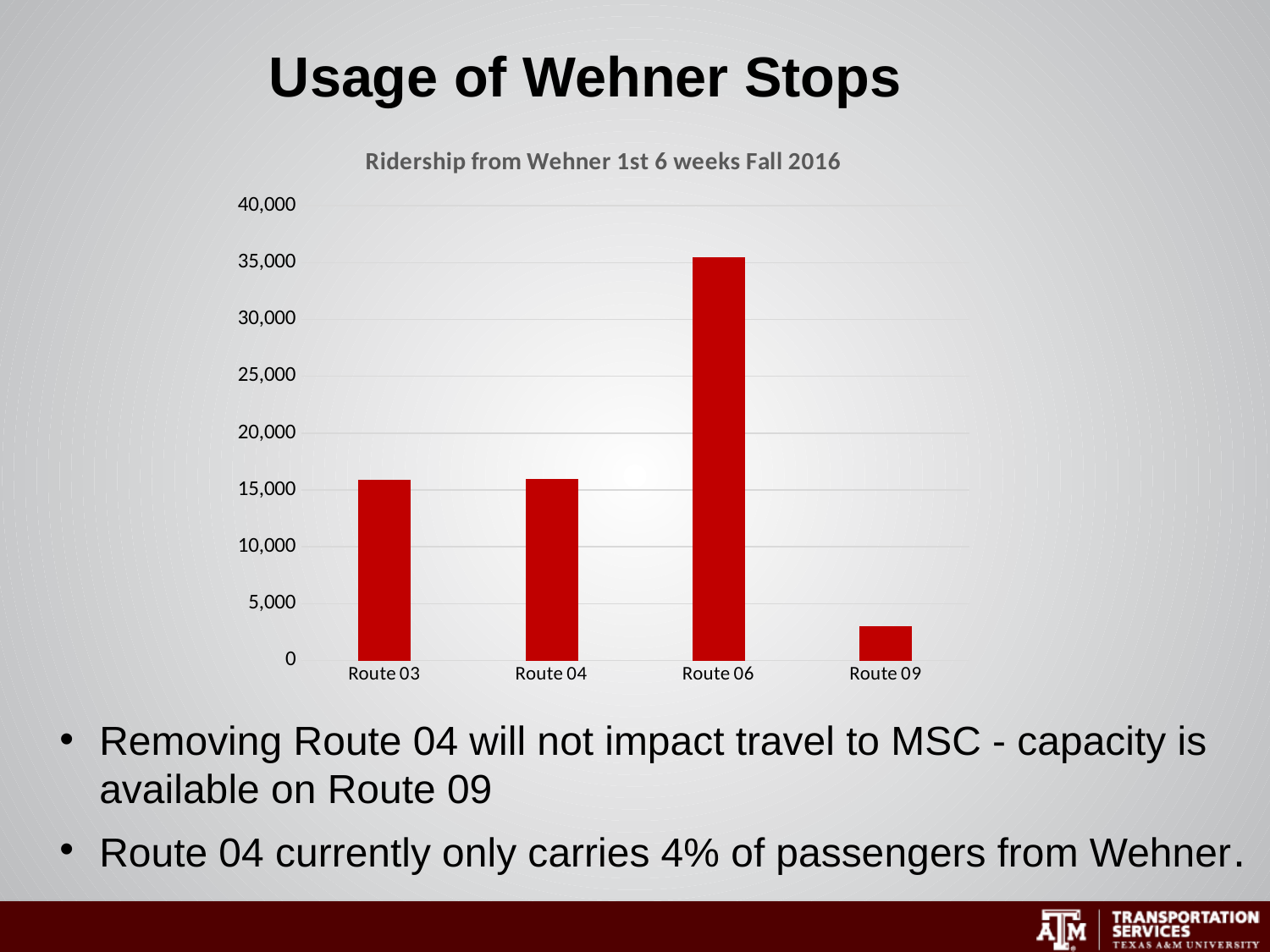
What is the title of the chart? Ridership from Wehner 1st 6 weeks Fall 2016 Which route has the highest ridership in the chart? Route 06 Is the value for Route 03 greater or less than 10,000? greater Which route has the lowest ridership in the chart? Route 09 How many routes are shown on the x axis of the chart? 4 What colour are the bars in the chart? red Which has the larger ridership, Route 06 or Route 09? Route 06 What kind of chart is shown on the slide? bar chart Is the value for Route 04 greater or less than 20,000? less Is the value for Route 06 greater or less than 30,000? greater Which has the larger ridership, Route 04 or Route 06? Route 06